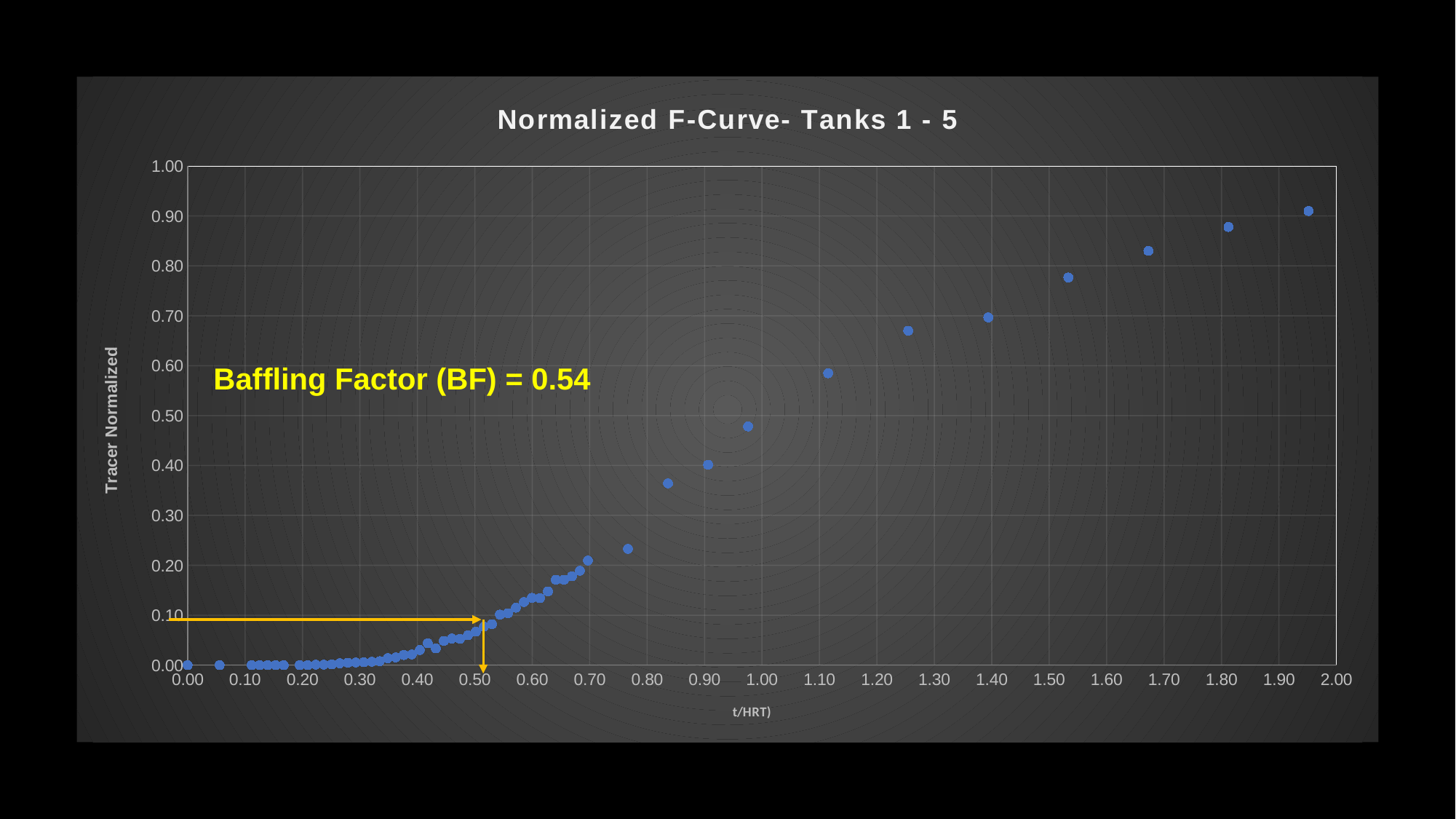
What Baffling Factor (BF) value is annotated on the chart? 0.54 Do the Tracer Normalized values rise or fall as t/HRT increases? rise Is the Tracer Normalized value for the point near t/HRT 0.70 greater or less than 0.30? less What is the title of the chart? Normalized F-Curve- Tanks 1 - 5 What is the maximum value shown on the y axis? 1.00 Is the Tracer Normalized value for the point near t/HRT 1.10 greater or less than 0.50? greater What kind of chart is shown on the slide? scatter chart Which of the two points has the larger Tracer Normalized value: the one near t/HRT 0.90 or the one near t/HRT 1.40? the one near t/HRT 1.40 Is the Tracer Normalized value for the point near t/HRT 1.67 greater or less than 0.80? greater